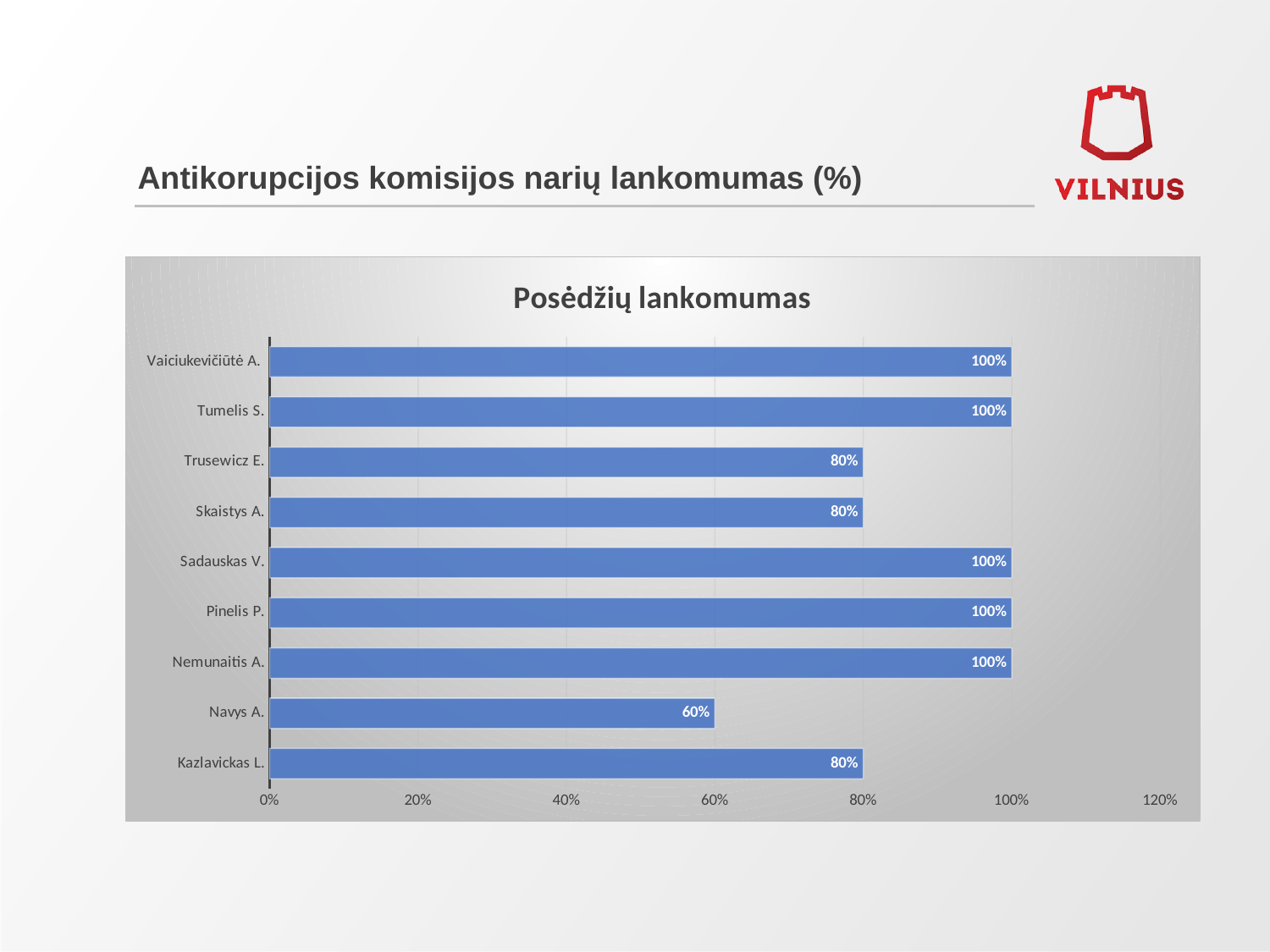
What is the attendance value for Navys A.? 60% What is the title of the chart? Posėdžių lankomumas Which member has the lowest attendance? Navys A. What is the attendance value for Sadauskas V.? 100% What is the attendance value for Trusewicz E.? 80% What is the difference between the attendance of Tumelis S. and Navys A.? 40% Is the value for Navys A. greater or less than 80%? less How many members are shown in the chart? 9 What is the difference between the attendance of Kazlavickas L. and Navys A.? 20% Which is larger, the attendance of Skaistys A. or Pinelis P.? Pinelis P. What kind of chart is shown on the slide? bar chart How many members have an attendance of 100%? 5